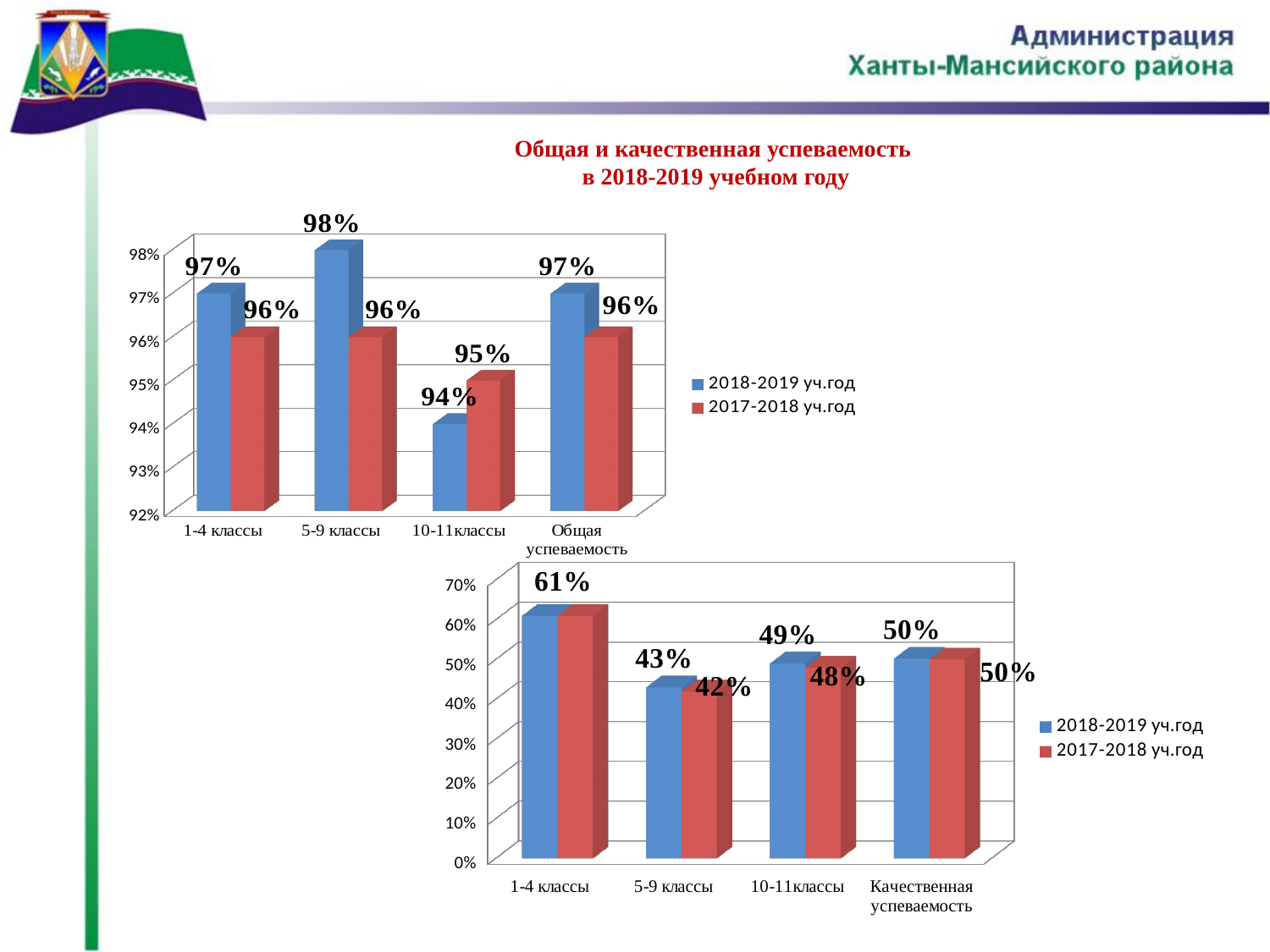
On the top chart, what is the value for 10-11классы in the 2017-2018 уч.год series? 95% On the top chart, which category has the lowest value in the 2018-2019 уч.год series? 10-11классы On the bottom chart, what is the value for 1-4 классы in the 2018-2019 уч.год series? 61% On the top chart, what is the value for 5-9 классы in the 2018-2019 уч.год series? 98% What type of chart is the top chart? Bar chart On the bottom chart, is the 2017-2018 уч.год value for 1-4 классы greater or less than 50%? greater On the bottom chart, what is the value for 5-9 классы in the 2017-2018 уч.год series? 42% On the top chart, which category has the highest value in the 2018-2019 уч.год series? 5-9 классы On the bottom chart, which category has the lowest value in the 2018-2019 уч.год series? 5-9 классы How many series does the legend of the bottom chart list? 2 On the top chart, for 10-11классы, which series has the larger value: 2018-2019 уч.год or 2017-2018 уч.год? 2017-2018 уч.год On the top chart, what is the difference between the 2018-2019 уч.год and 2017-2018 уч.год values for 5-9 классы? 2%